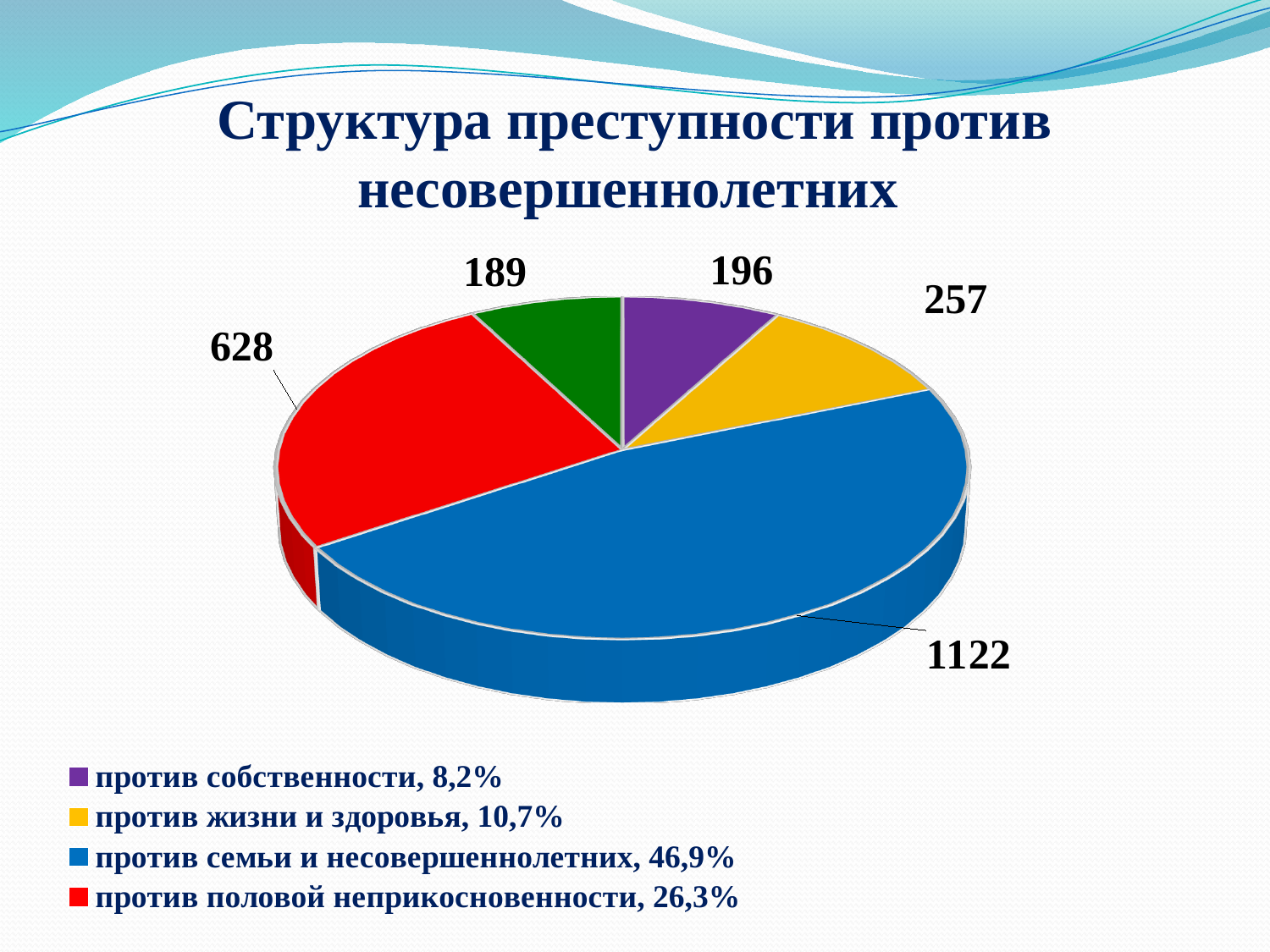
Which category has the largest slice of the pie? против семьи и несовершеннолетних What is the difference between the values for "против семьи и несовершеннолетних" and "против половой неприкосновенности"? 494 What is the smallest value shown on the pie chart? 189 What type of chart is shown on the slide? pie chart Which is larger, the value for "против жизни и здоровья" or the value for "против собственности"? против жизни и здоровья What is the value for "против жизни и здоровья"? 257 How many slices does the pie chart have? 5 What is the value for "против собственности"? 196 What is the value for "против половой неприкосновенности"? 628 What share of the pie does "против половой неприкосновенности" represent? 26,3% How many entries does the legend list? 4 What is the value for "против семьи и несовершеннолетних"? 1122